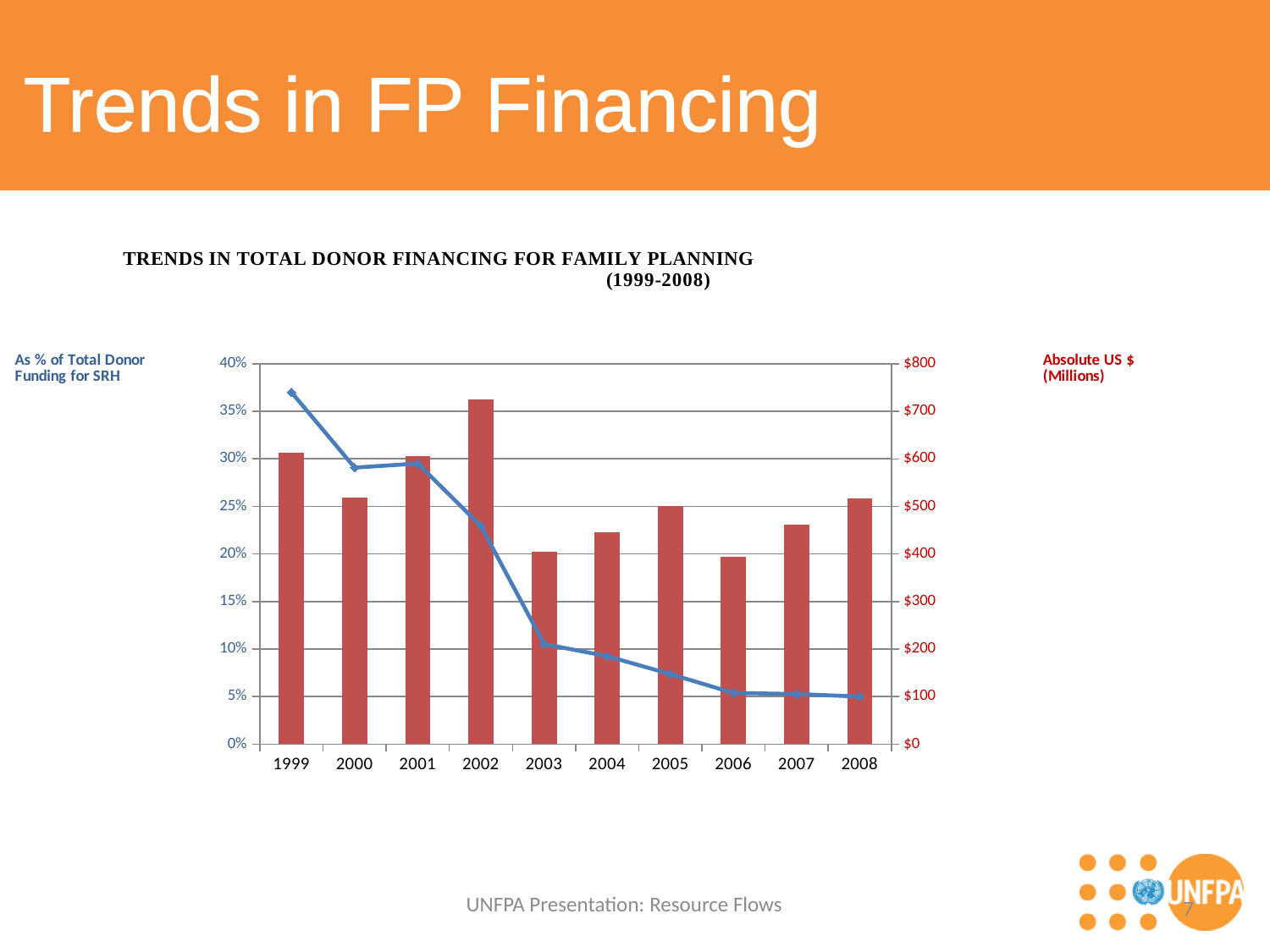
Is the % of total donor funding for SRH in 2008 greater or less than 10%? less Is the absolute US $ value for 2003 greater or less than $500? less Does the line for % of total donor funding for SRH generally rise or fall from 1999 to 2008? Fall Which year has the tallest bar for absolute US $ (millions)? 2002 What is the title of the chart? TRENDS IN TOTAL DONOR FINANCING FOR FAMILY PLANNING (1999-2008) What kind of chart is shown on the slide? A combination bar and line chart Is the % of total donor funding for SRH in 1999 greater or less than 35%? greater Which year has the higher % of total donor funding for SRH, 2000 or 2004? 2000 In which year is the line for % of total donor funding for SRH at its highest? 1999 How many years are plotted along the x axis of the chart? 10 Which year has the larger absolute US $ bar, 2002 or 2005? 2002